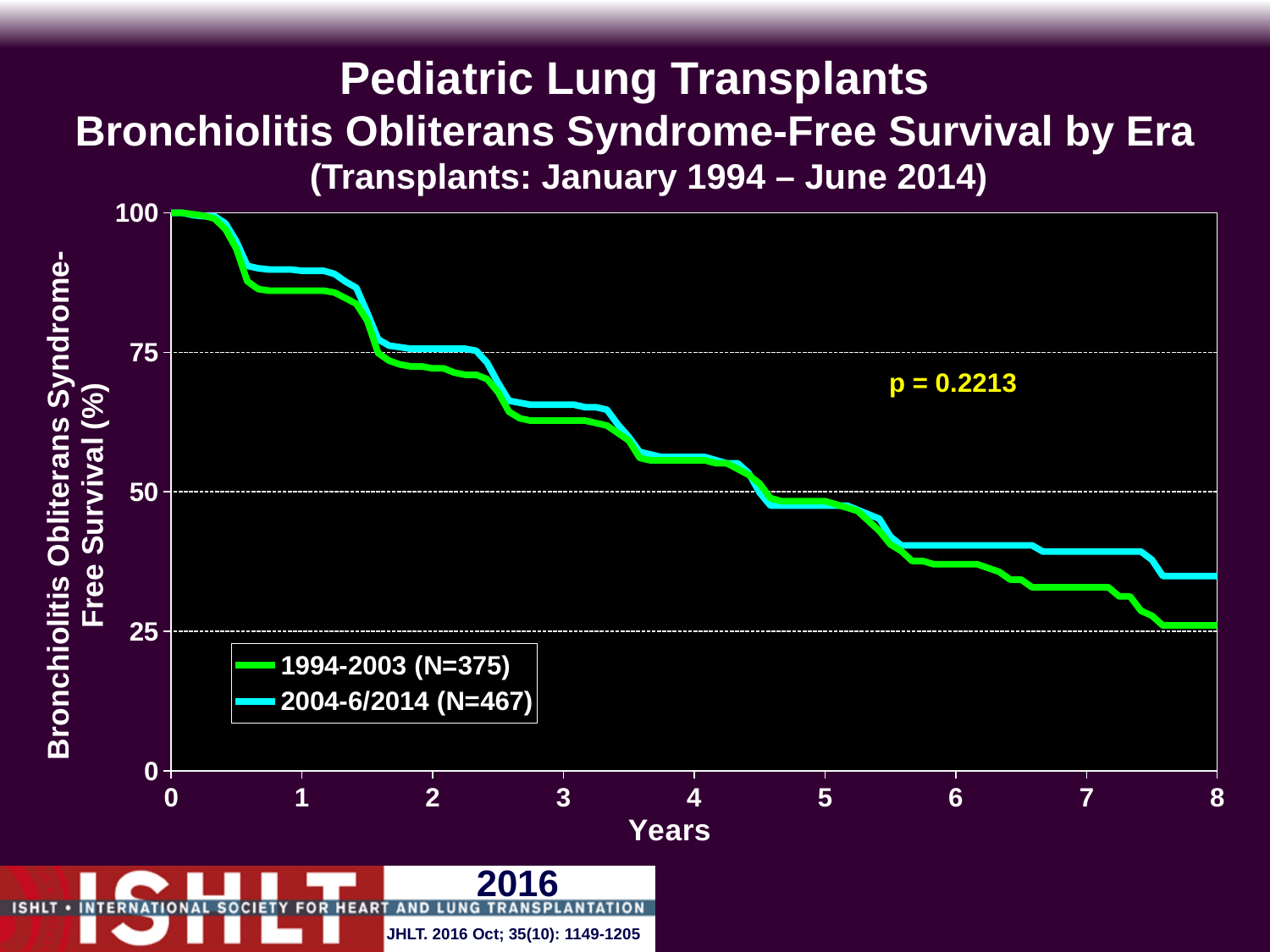
At 7 years, which series has the higher BOS-free survival, 1994-2003 or 2004-6/2014? 2004-6/2014 Is the BOS-free survival for the 1994-2003 group at 6 years greater or less than 50? less Is the BOS-free survival for the 2004-6/2014 group at 4 years greater or less than 50? greater Is the BOS-free survival for the 1994-2003 group at 1 year greater or less than 75? greater At 8 years, which series has the higher BOS-free survival, 1994-2003 or 2004-6/2014? 2004-6/2014 According to the legend, how many patients are in the 2004-6/2014 group? N=467 What kind of chart is shown on the slide? Line chart Do the survival values rise or fall as years increase along the x axis? Fall What is the p-value printed on the chart? p = 0.2213 How many series does the legend list? 2